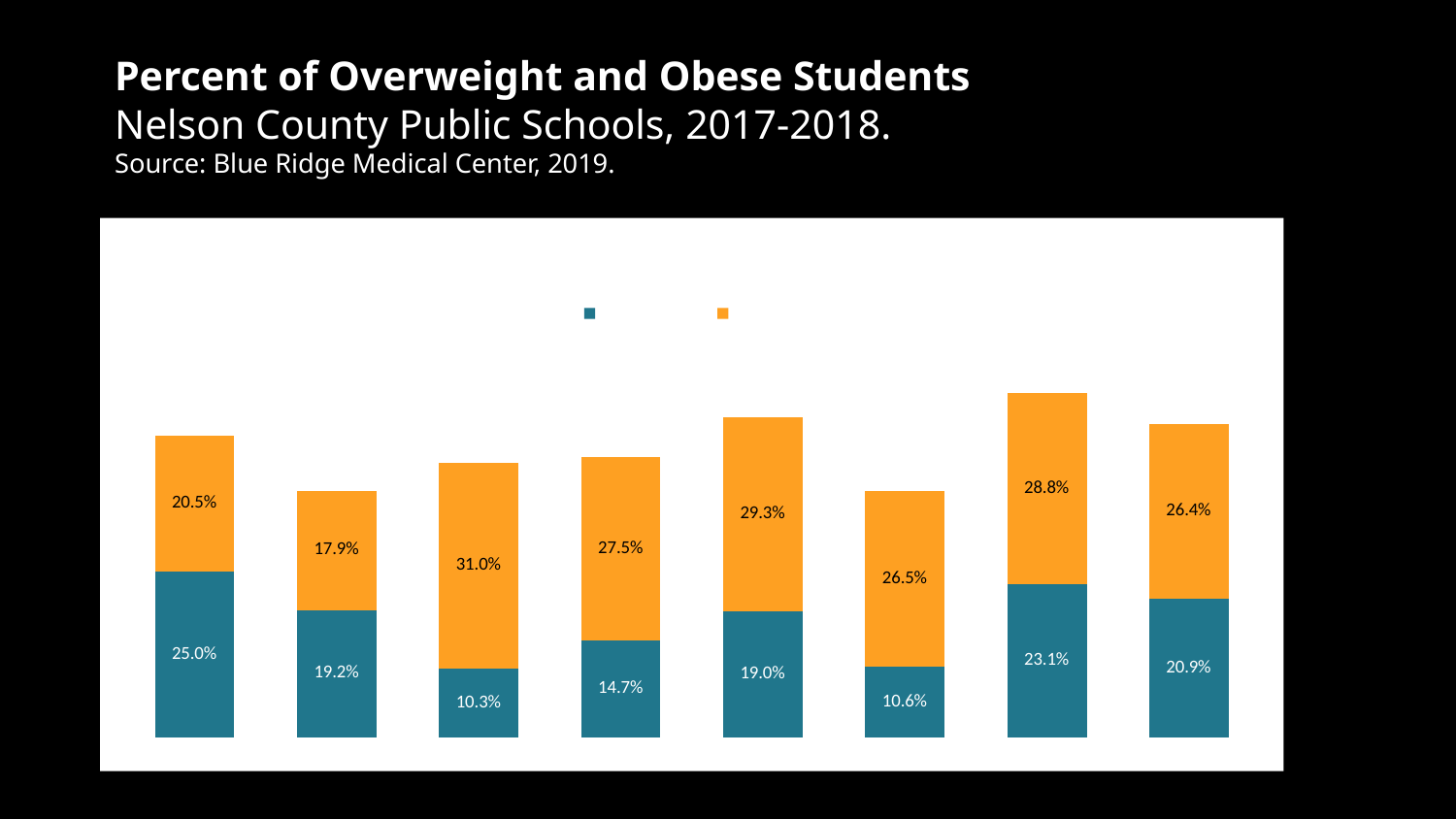
What is the value of the orange (top) segment of the third bar from the left? 31.0% How many series does the legend list? 2 Which is larger: the teal segment of the eighth bar or the teal segment of the fourth bar? The eighth bar (20.9%) What is the difference between the orange segment values of the fifth bar (29.3%) and the second bar (17.9%)? 11.4% Which bar has the highest orange (top) segment value? The third bar from the left (31.0%) What is the total of the two segments in the seventh bar from the left? 51.9% Which bar has the lowest teal (bottom) segment value? The third bar from the left (10.3%) What is the value of the teal (bottom) segment of the first bar from the left? 25.0% How many bars are plotted in the chart? 8 What is the value of the teal (bottom) segment of the seventh bar from the left? 23.1% What is the title of the chart on the slide? Percent of Overweight and Obese Students What kind of chart is shown on the slide? Stacked bar chart